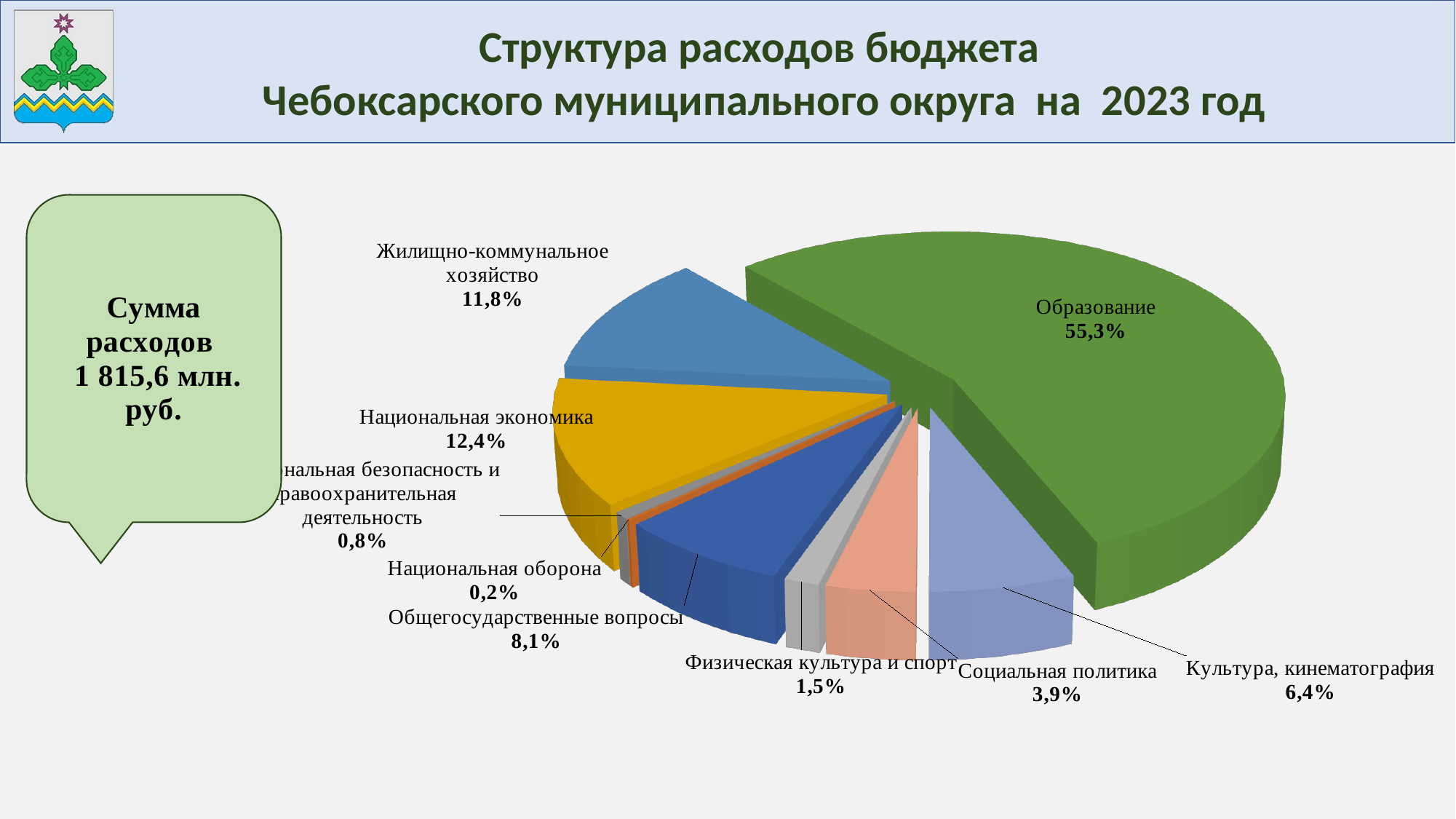
What percentage is shown for Жилищно-коммунальное хозяйство? 11,8% What type of chart is shown on the slide? Pie chart What share is shown for Социальная политика? 3,9% Which category has the largest slice of the pie? Образование What is the difference in percentage points between Национальная экономика and Жилищно-коммунальное хозяйство? 0,6 Which category has the smallest slice of the pie? Национальная оборона What is the value shown for Национальная экономика? 12,4% Which is larger: Культура, кинематография or Социальная политика? Культура, кинематография How many categories (slices) does the pie chart show? 9 What share of the budget expenditure does Образование account for? 55,3% What is the value shown for Общегосударственные вопросы? 8,1% What total expenditure amount is stated in the callout box on the left of the slide? 1 815,6 млн. руб.